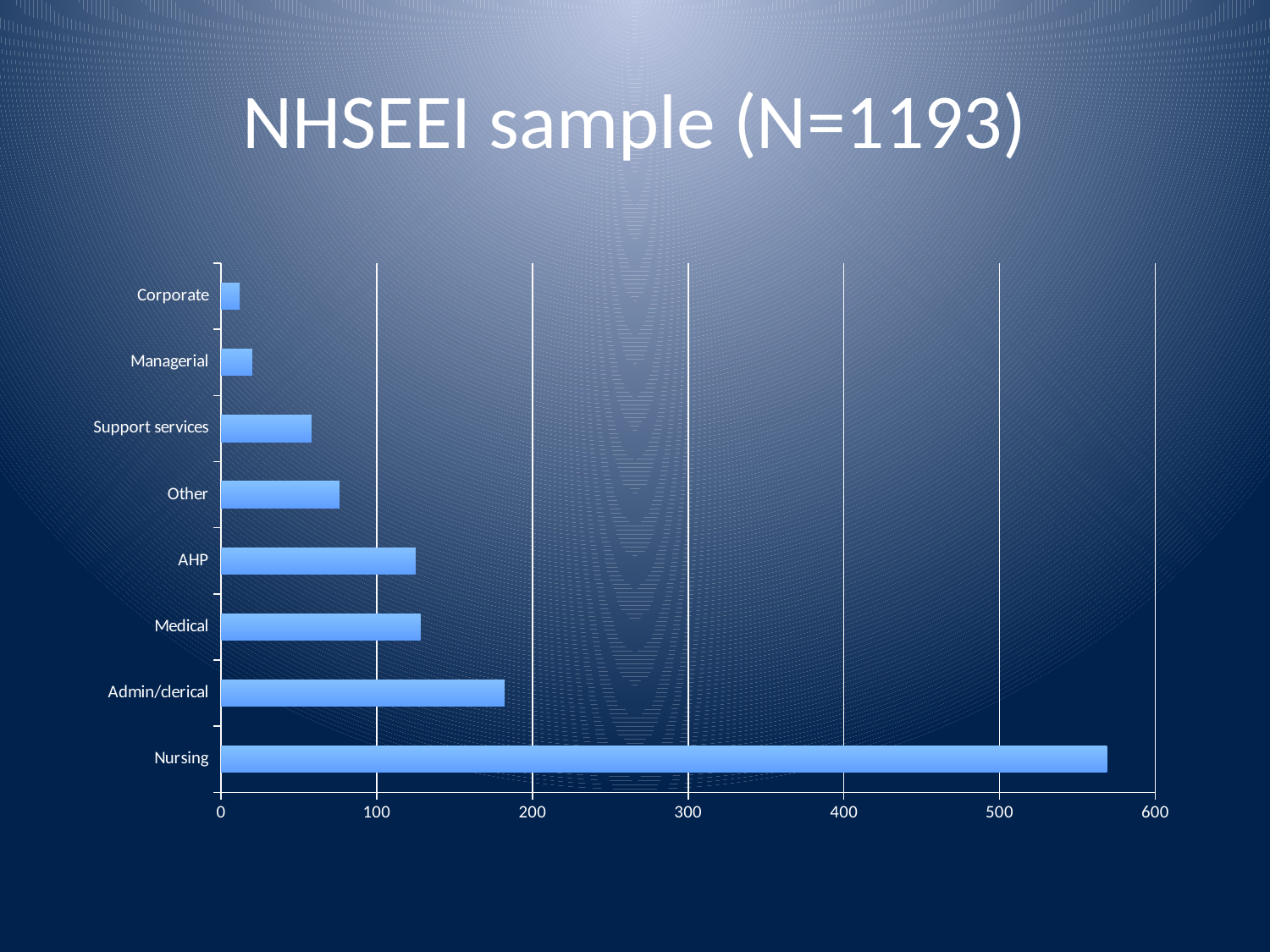
Is the value for Admin/clerical greater or less than 200? less What kind of chart is shown on the slide? bar chart Is the value for AHP greater or less than 100? greater Which category has the lowest value? Corporate Is the value for Nursing greater or less than 500? greater Which category has the highest value? Nursing Which is larger, the value for Admin/clerical or the value for Medical? Admin/clerical Which is larger, the value for Other or the value for Managerial? Other How many categories are plotted in the chart? 8 What is the title of the chart? NHSEEI sample (N=1193)